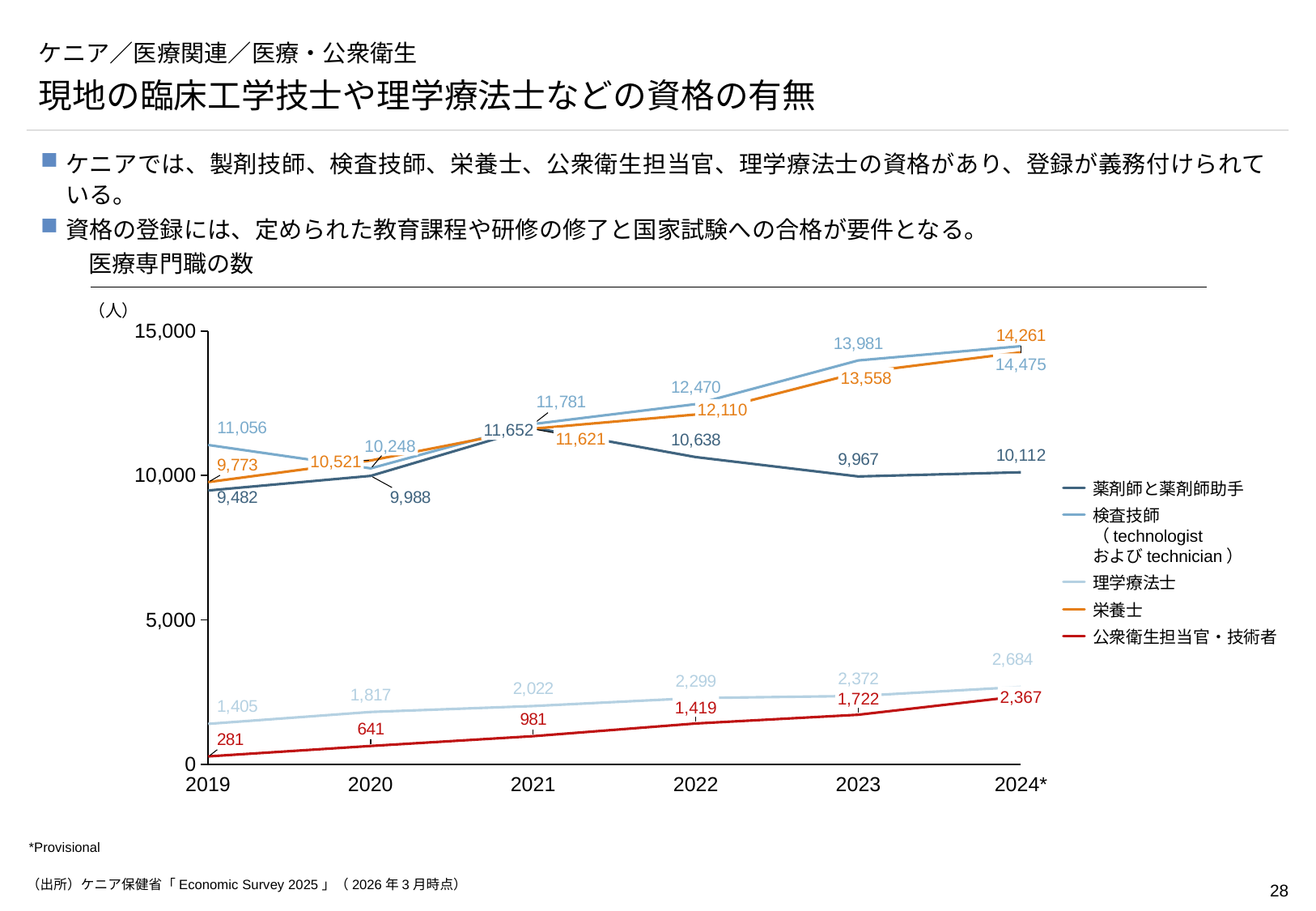
このグラフの種類は何ですか。 折れ線グラフ 2023年の栄養士の人数はいくらですか。 13,558 2024*年の検査技師の人数はいくらですか。 14,475 2024*年に人数が最も少ない職種はどれですか。 公衆衛生担当官・技術者 2021年の薬剤師と薬剤師助手の人数はいくらですか。 11,652 薬剤師と薬剤師助手の人数が最も多かった年はどれですか。 2021 横軸には何年分のデータ点がありますか。 6 2020年の検査技師と栄養士では、どちらの人数が多いですか。 栄養士 2024*年の理学療法士と公衆衛生担当官・技術者の人数の差はいくらですか。 317 公衆衛生担当官・技術者の人数は2019年から2024*年にかけて増加していますか、減少していますか。 増加 2019年の公衆衛生担当官・技術者の人数はいくらですか。 281 凡例にはいくつの系列が示されていますか。 5